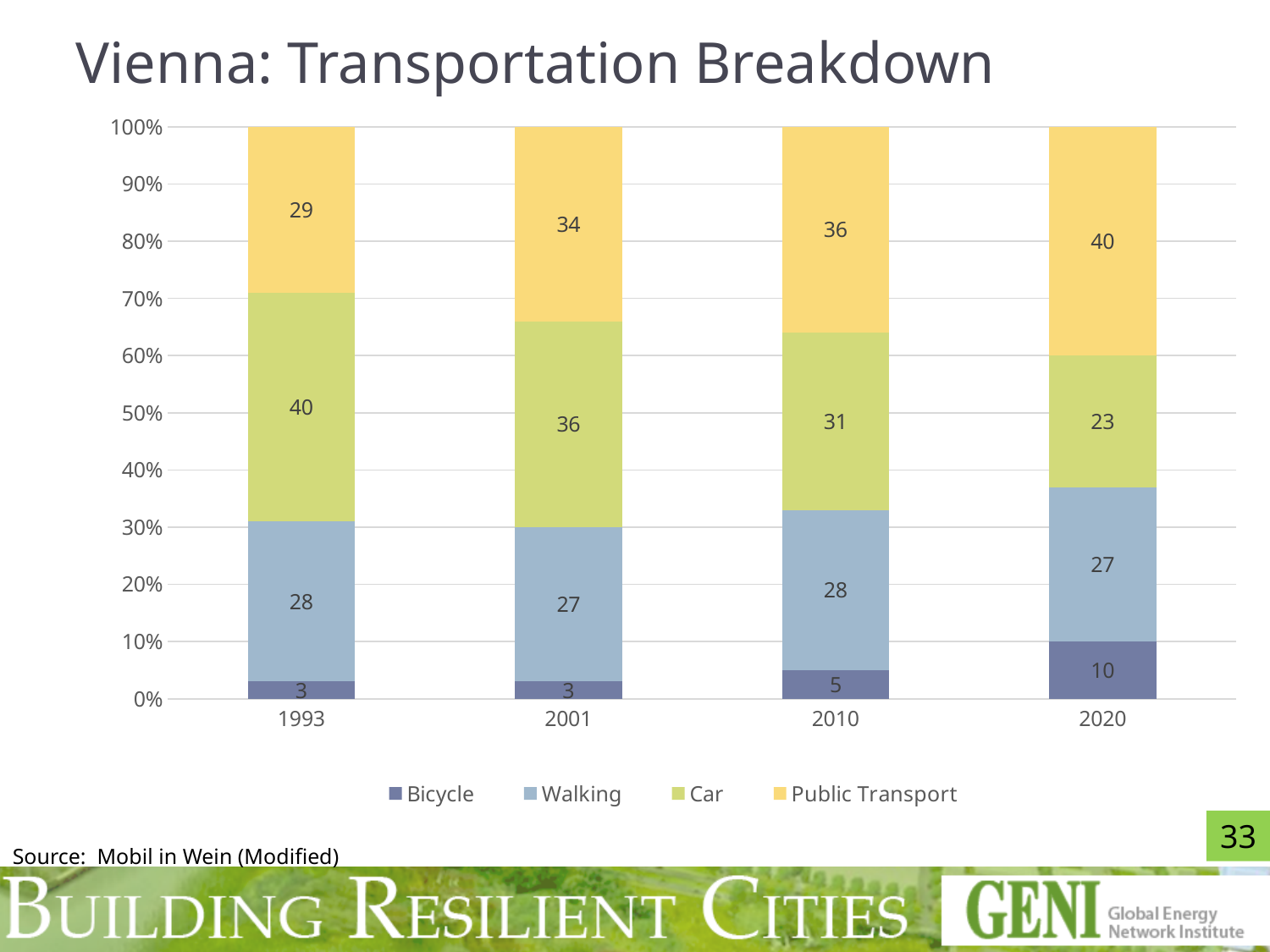
What is the value for Bicycle in 2010? 5 What is the value for Car in 1993? 40 In which year is the Public Transport value highest? 2020 How many years are shown on the x axis? 4 What kind of chart is shown on the slide? Stacked bar chart Which is larger in 2010: the Car value or the Public Transport value? Public Transport What is the difference between the Car value in 1993 and the Car value in 2020? 17 In which year is the Car value lowest? 2020 Does the Bicycle value rise or fall from 1993 to 2020? Rise What is the value for Walking in 2001? 27 What is the value for Public Transport in 2020? 40 How many series does the legend list? 4